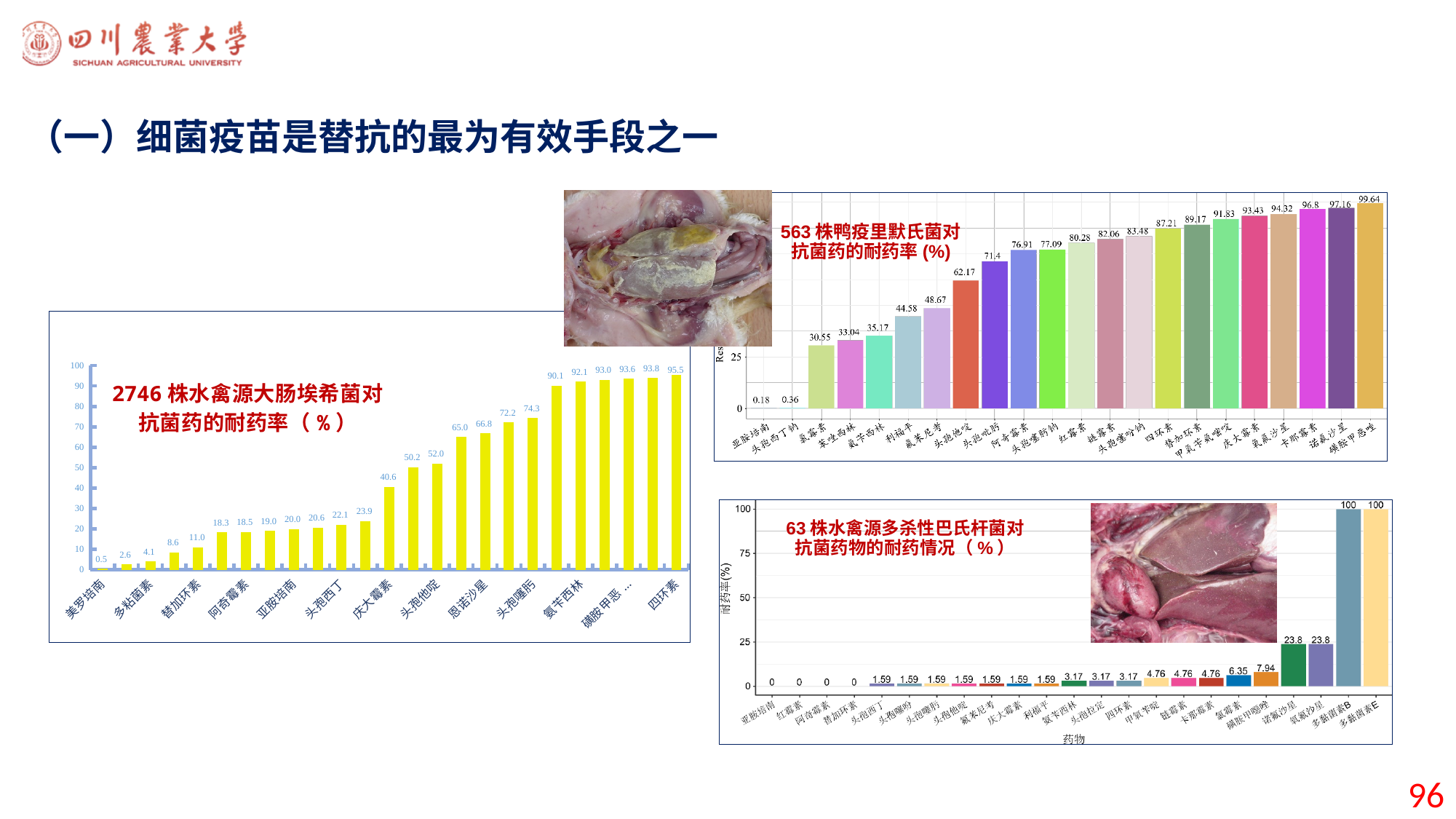
In the chart titled 63 株水禽源多杀性巴氏杆菌对抗菌药物的耐药情况（%）, how many antibiotics are plotted on the x axis? 23 In the chart titled 63 株水禽源多杀性巴氏杆菌对抗菌药物的耐药情况（%）, which is larger, the value for 氯霉素 or the value for 诺氟沙星? 诺氟沙星 In the chart titled 2746 株水禽源大肠埃希菌对抗菌药的耐药率（%）, do the values rise or fall from left to right along the x axis? rise In the chart titled 63 株水禽源多杀性巴氏杆菌对抗菌药物的耐药情况（%）, what is the value for 磺胺甲噁唑? 7.94 In the chart titled 563 株鸭疫里默氏菌对抗菌药的耐药率(%), what is the value for 磺胺甲恶唑? 99.64 In the chart titled 2746 株水禽源大肠埃希菌对抗菌药的耐药率（%）, which antibiotic has the highest resistance rate? 四环素 In the chart titled 563 株鸭疫里默氏菌对抗菌药的耐药率(%), which antibiotic has the lowest resistance rate? 亚胺培南 What kind of chart is the one titled 63 株水禽源多杀性巴氏杆菌对抗菌药物的耐药情况（%）? bar chart In the chart titled 563 株鸭疫里默氏菌对抗菌药的耐药率(%), how many antibiotics are plotted? 22 In the chart titled 2746 株水禽源大肠埃希菌对抗菌药的耐药率（%）, what is the difference between the highest value (95.5) and the lowest value (0.5)? 95.0 In the chart titled 563 株鸭疫里默氏菌对抗菌药的耐药率(%), what is the value for 氟苯尼考? 48.67 In the chart titled 2746 株水禽源大肠埃希菌对抗菌药的耐药率（%）, what is the value for 美罗培南? 0.5